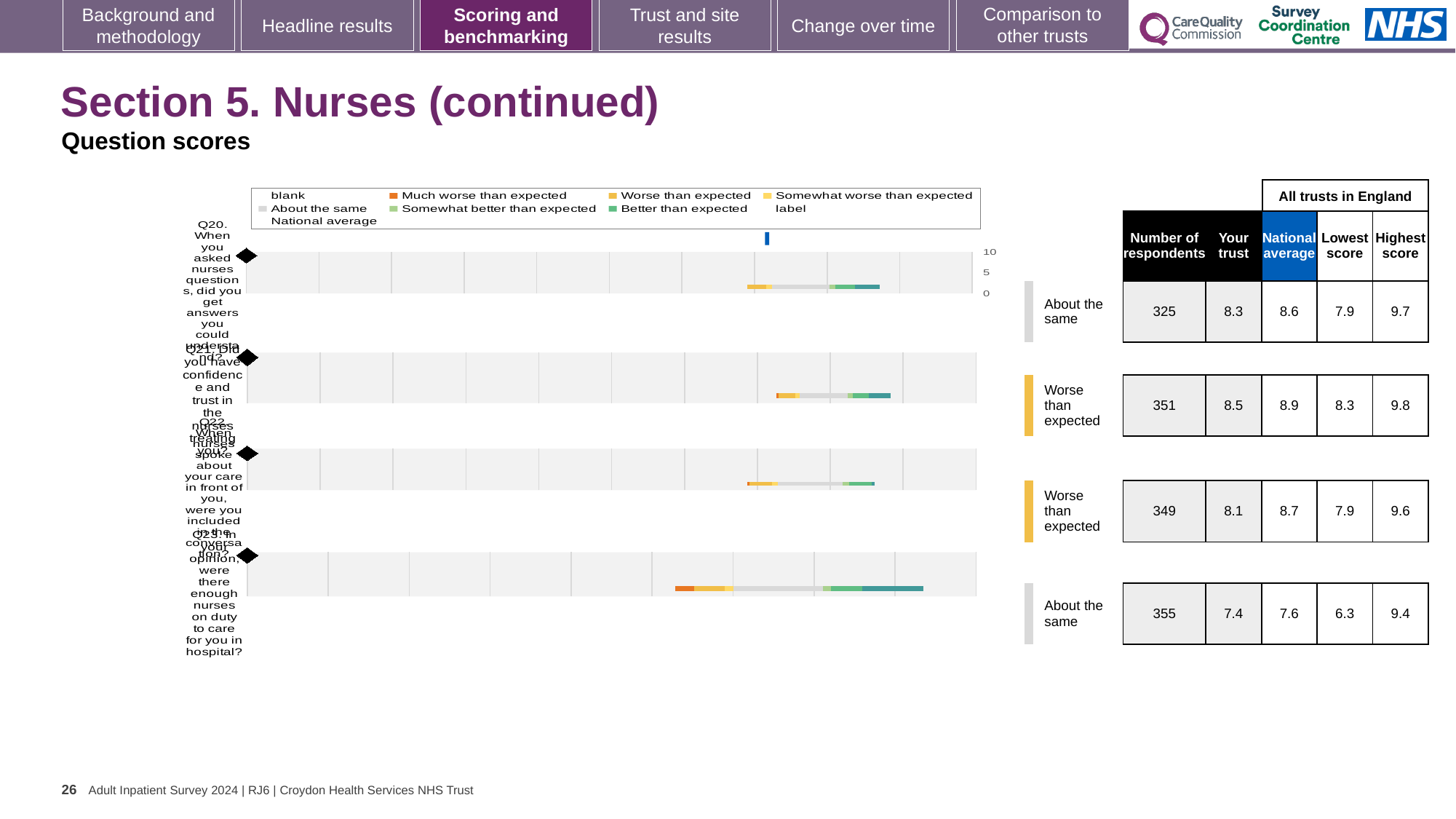
Which question has the lowest 'Your trust' score in the table beside the chart? Q23 What benchmark category label is shown next to the chart for Q22? Worse than expected In the table beside the chart, what is the national average for Q22 (When nurses spoke about your care in front of you, were you included in the conversation)? 8.7 In the table beside the chart, what is the number of respondents for Q20 (When you asked nurses questions, did you get answers you could understand)? 325 What is the difference between the national average and the 'Your trust' score for Q23? 0.2 In the table beside the chart, what is the 'Your trust' score for Q21 (Did you have confidence and trust in the nurses treating you)? 8.5 Which question has the highest number of respondents in the table beside the chart? Q23 What kind of chart is used to show the question scores for Q20 to Q23? bar chart What is the difference between the highest score and the lowest score for Q21? 1.5 How many questions (rows) are plotted in the chart? 4 Which has the larger 'Your trust' score, Q21 or Q22? Q21 In the table beside the chart, what is the lowest score across all trusts in England for Q23 (were there enough nurses on duty to care for you in hospital)? 6.3